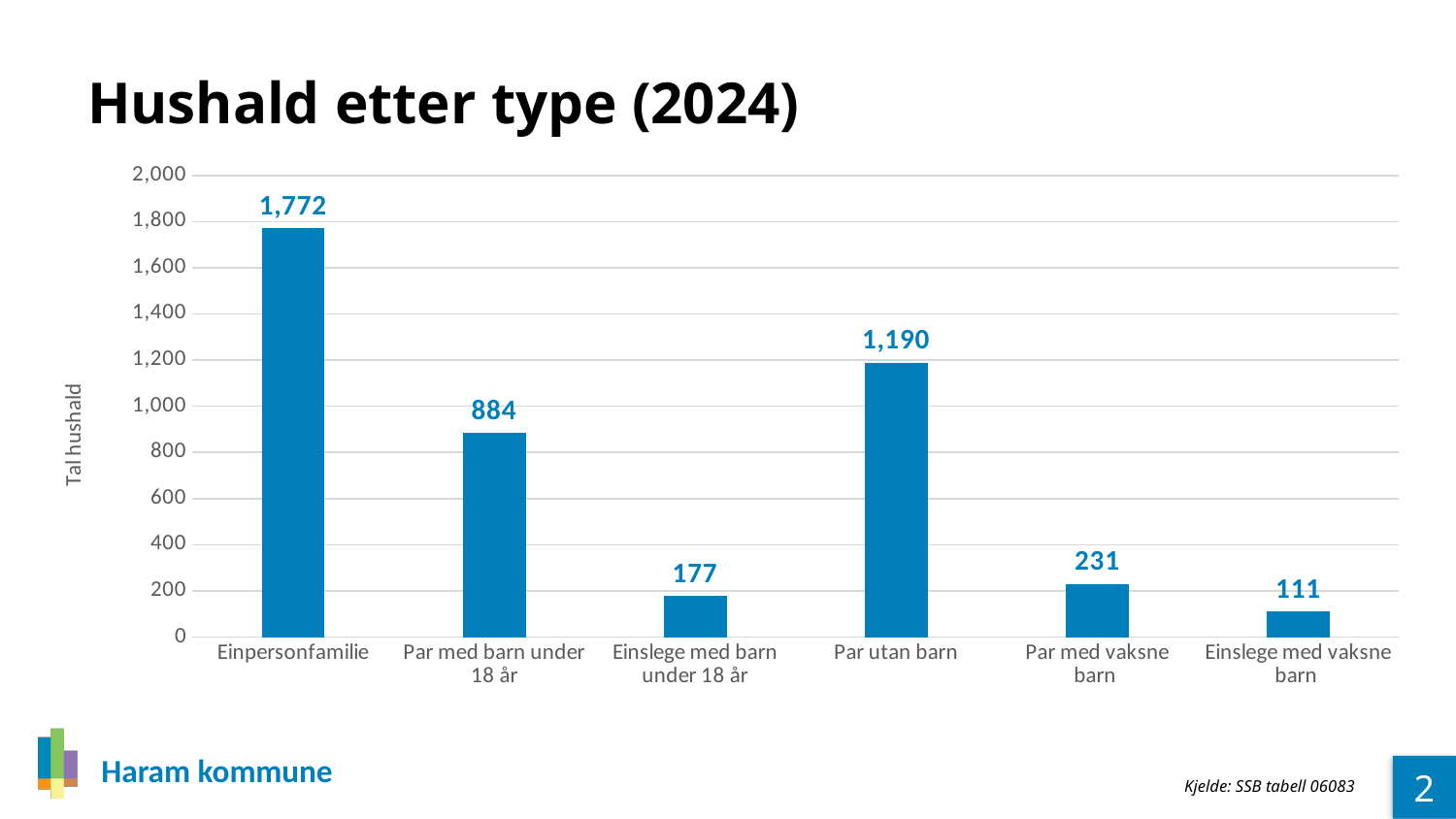
What kind of chart is shown on the slide? bar chart Which is larger, Par med barn under 18 år or Par med vaksne barn? Par med barn under 18 år What is the value for Einslege med vaksne barn? 111 What is the value for Einpersonfamilie? 1,772 What is the value for Einslege med barn under 18 år? 177 Which household type has the highest value? Einpersonfamilie What is the value for Par utan barn? 1,190 Which household type has the lowest value? Einslege med vaksne barn What is the title of the chart? Hushald etter type (2024) How many household types are shown on the chart? 6 Is the value for Par med barn under 18 år greater or less than 1,000? less What is the difference between Einpersonfamilie and Par utan barn? 582